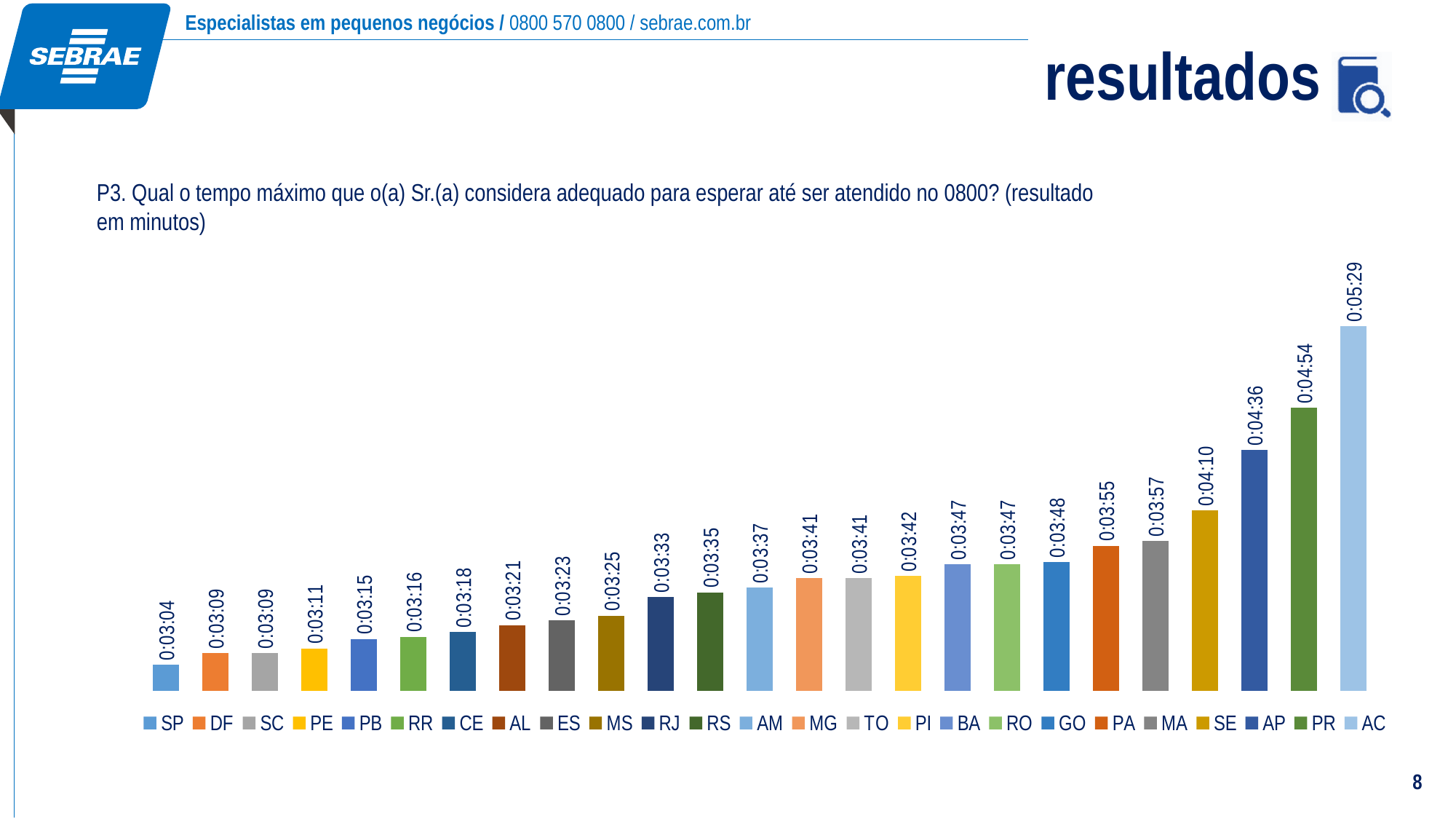
Do the values rise or fall from left to right along the x axis? Rise Which state has the highest value in the chart? AC How many bars (states) are shown in the chart? 25 How many entries does the legend list? 25 What is the value shown for SP? 0:03:04 What is the value shown for AP? 0:04:36 What is the value shown for GO? 0:03:48 Which state has the lowest value in the chart? SP What is the value shown for MS? 0:03:25 Which has a larger value, PR or SE? PR What type of chart is shown on the slide? Bar chart What is the difference between the values for AP and SE? 26 seconds